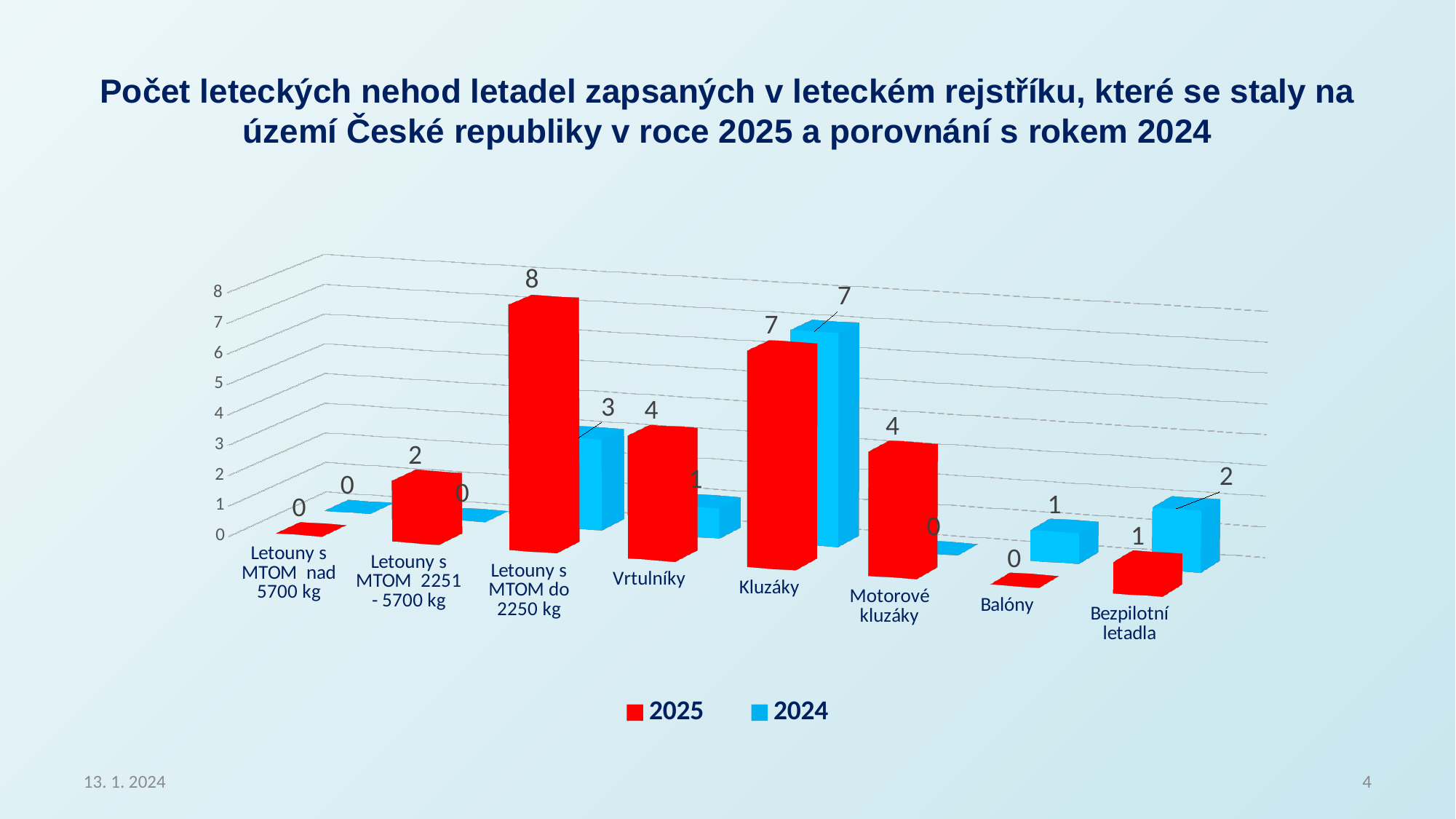
What is the 2025 value for Letouny s MTOM do 2250 kg? 8 Which is larger for Balóny, the 2025 value or the 2024 value? 2024 What is the 2024 value for Bezpilotní letadla? 2 Which colour represents the 2024 series in the legend? blue What is the 2024 value for Vrtulníky? 1 Which category has the highest 2024 value? Kluzáky How many categories are shown on the x axis? 8 What kind of chart is shown on the slide? bar chart How many series does the legend list? 2 What is the difference between the 2025 and 2024 values for Letouny s MTOM do 2250 kg? 5 Which category has the highest 2025 value? Letouny s MTOM do 2250 kg What is the 2025 value for Motorové kluzáky? 4